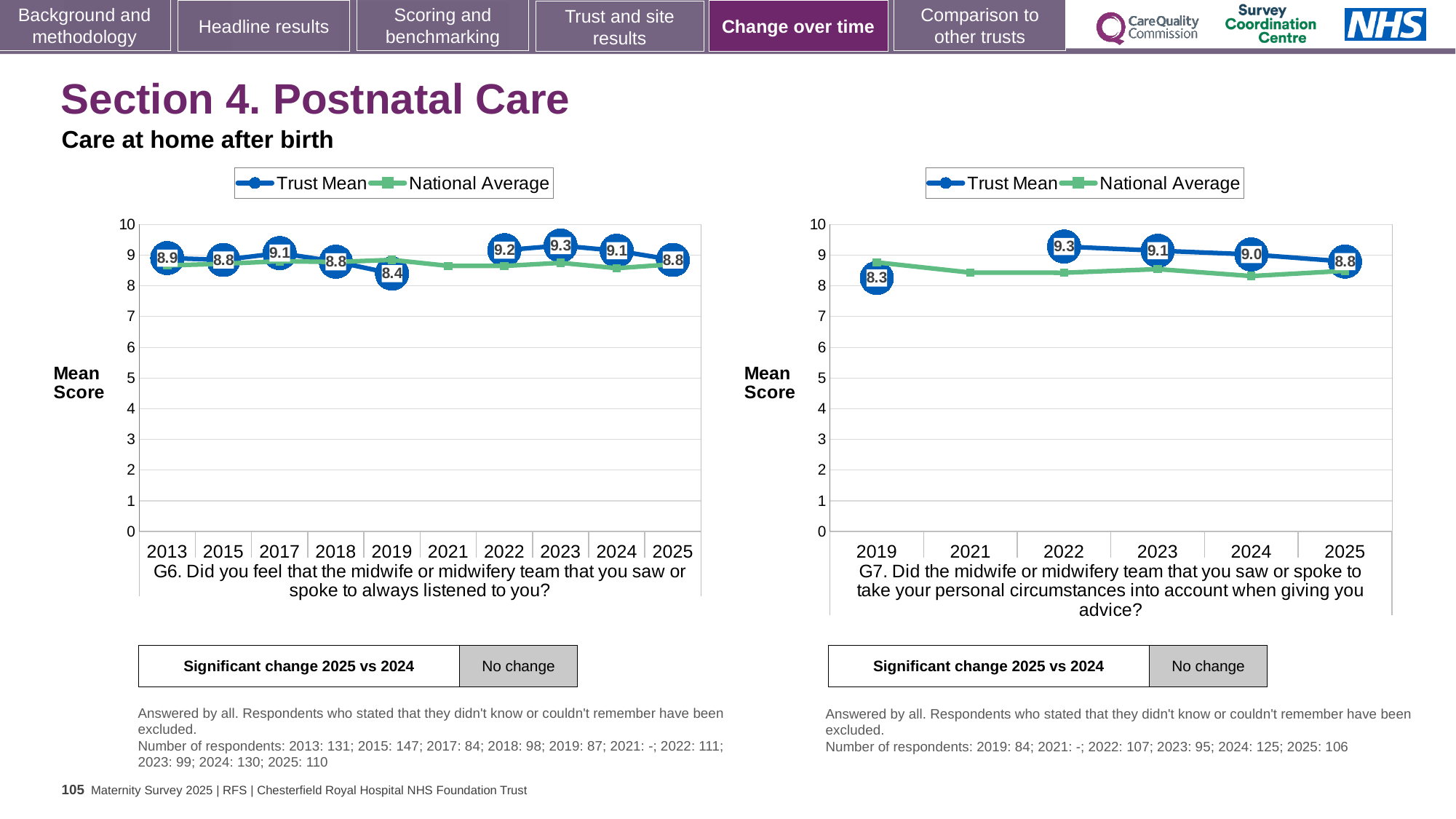
In the G6 chart on the left, what is the Trust Mean score for 2019? 8.4 How many series does the legend of the G7 chart on the right list? 2 In the G7 chart on the right, which year has the lowest Trust Mean score? 2019 In the G6 chart on the left, what is the Trust Mean score for 2023? 9.3 In the G7 chart on the right, is the National Average value for 2024 greater or less than 9? less In the G6 chart on the left, what is the difference between the Trust Mean scores for 2023 and 2019? 0.9 In the G6 chart on the left, which year has the highest Trust Mean score? 2023 What type of chart is the G6 chart on the left? Line chart In the G7 chart on the right, what is the Trust Mean score for 2022? 9.3 In the G7 chart on the right, is the Trust Mean score for 2023 or 2025 larger? 2023 How many years are shown on the x axis of the G6 chart on the left? 10 In the G7 chart on the right, what is the difference between the Trust Mean scores for 2022 and 2019? 1.0